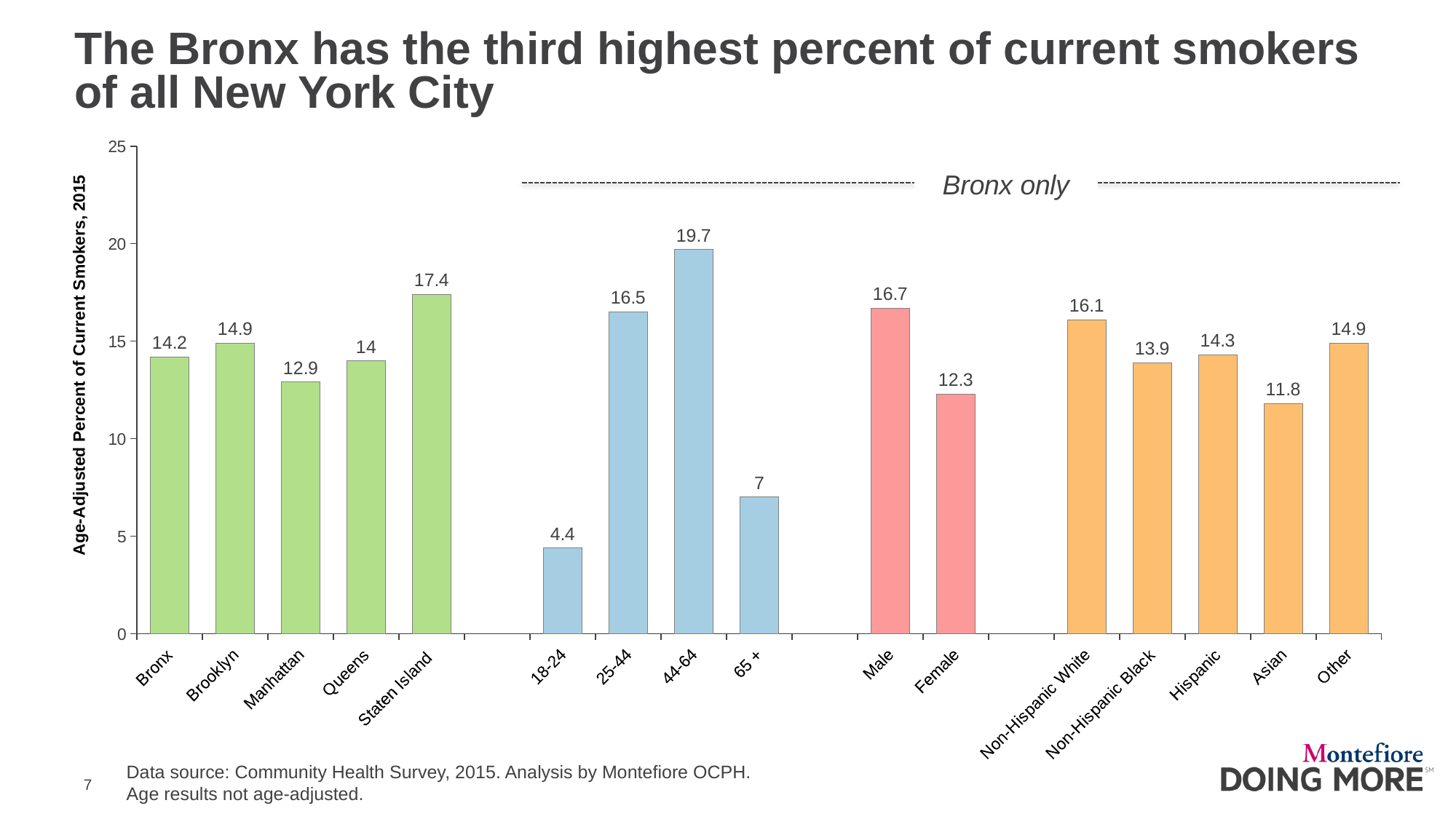
Which is larger, the value for Non-Hispanic White or the value for Non-Hispanic Black? Non-Hispanic White What is the value shown for Staten Island? 17.4 What is the age-adjusted percent of current smokers for the Bronx? 14.2 What is the label on the vertical axis of the chart? Age-Adjusted Percent of Current Smokers, 2015 Is the value for the 44-64 age group greater or less than 15? greater What is the value shown for the 65 + age group? 7 Which age group has the lowest percent of current smokers? 18-24 What is the difference between the Male and Female values? 4.4 What is the difference between the Queens and Manhattan values? 1.1 Which of the five boroughs has the highest percent of current smokers? Staten Island What kind of chart is shown on the slide? Bar chart How many bars are plotted in the chart? 16